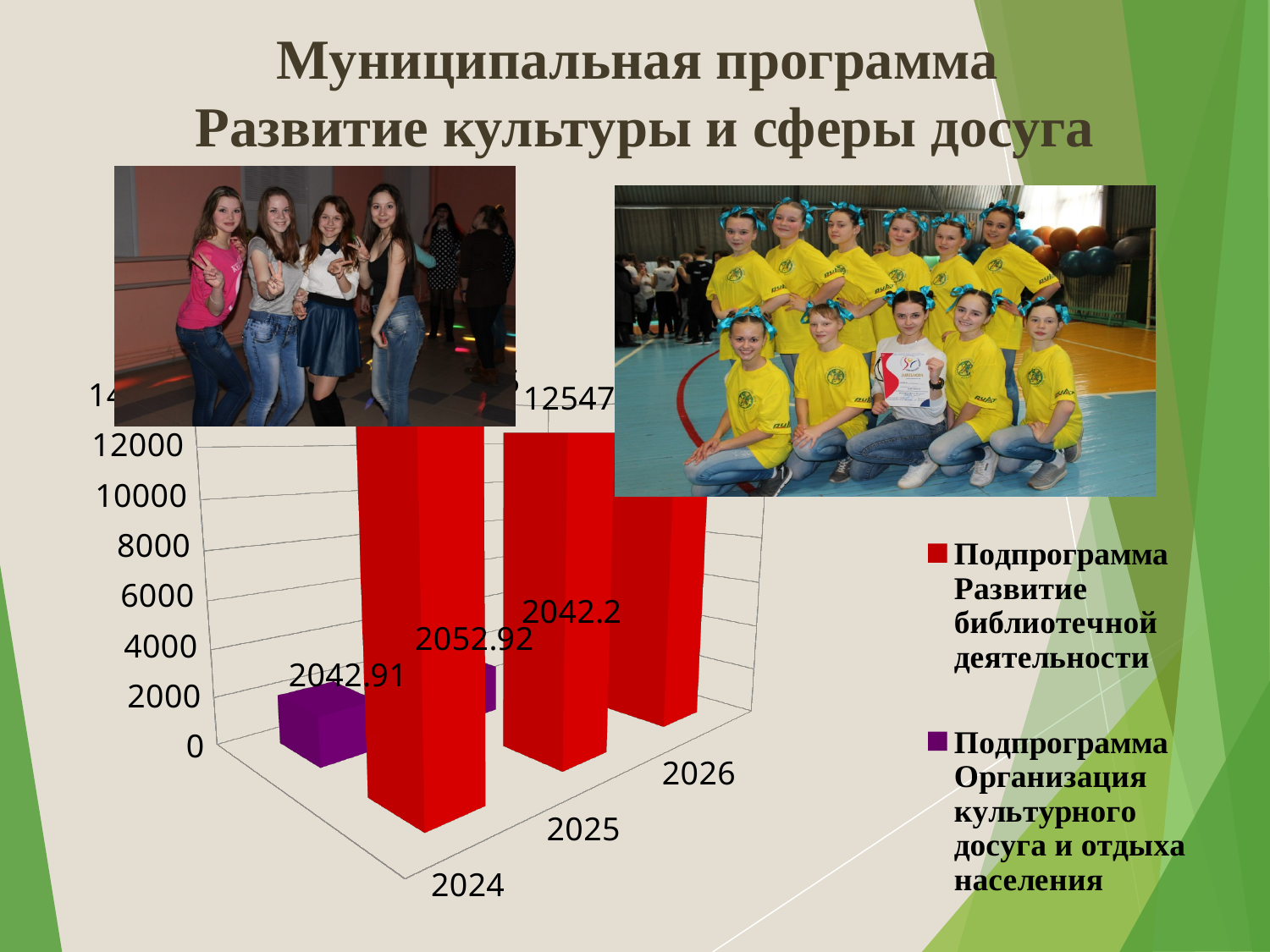
What is the difference between the 2025 and 2024 values for Подпрограмма Организация культурного досуга и отдыха населения? 10.01 In which year is the value for Подпрограмма Организация культурного досуга и отдыха населения the highest? 2025 What kind of chart is shown on the slide? bar chart Which colour represents Подпрограмма Развитие библиотечной деятельности in the chart? red How many years are shown on the x axis of the chart? 3 What is the value for Подпрограмма Организация культурного досуга и отдыха населения in 2024? 2042.91 What is the value for Подпрограмма Организация культурного досуга и отдыха населения in 2025? 2052.92 What is the value for Подпрограмма Организация культурного досуга и отдыха населения in 2026? 2042.2 In 2025, which series has the larger value: Подпрограмма Развитие библиотечной деятельности or Подпрограмма Организация культурного досуга и отдыха населения? Подпрограмма Развитие библиотечной деятельности In which year is the value for Подпрограмма Организация культурного досуга и отдыха населения the lowest? 2026 How many series does the chart legend list? 2